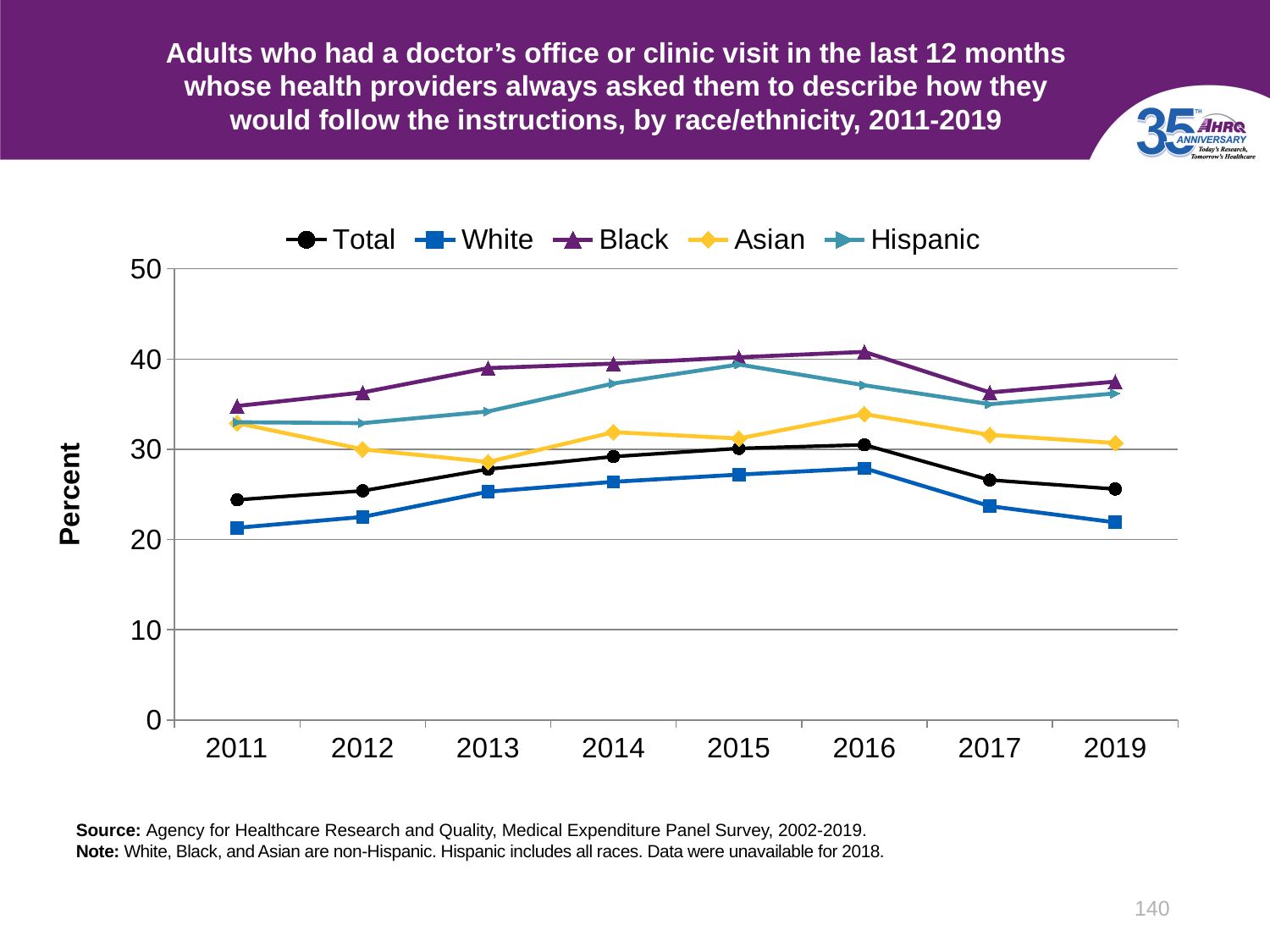
What is the label on the y axis? Percent Which race/ethnicity group has the highest value in 2016? Black Is the value for Hispanic in 2014 greater or less than 30? greater What kind of chart is shown on the slide? line chart In 2015, which is larger, the value for Hispanic or the value for Asian? Hispanic How many series does the legend list? 5 Does the White series rise or fall from 2011 to 2016? rise Which year between 2011 and 2019 is missing from the x axis? 2018 Is the value for White in 2011 greater or less than 25? less How many years are shown on the x axis? 8 Which race/ethnicity group has the lowest value in 2019? White Is the value for Black in 2016 greater or less than 40? greater